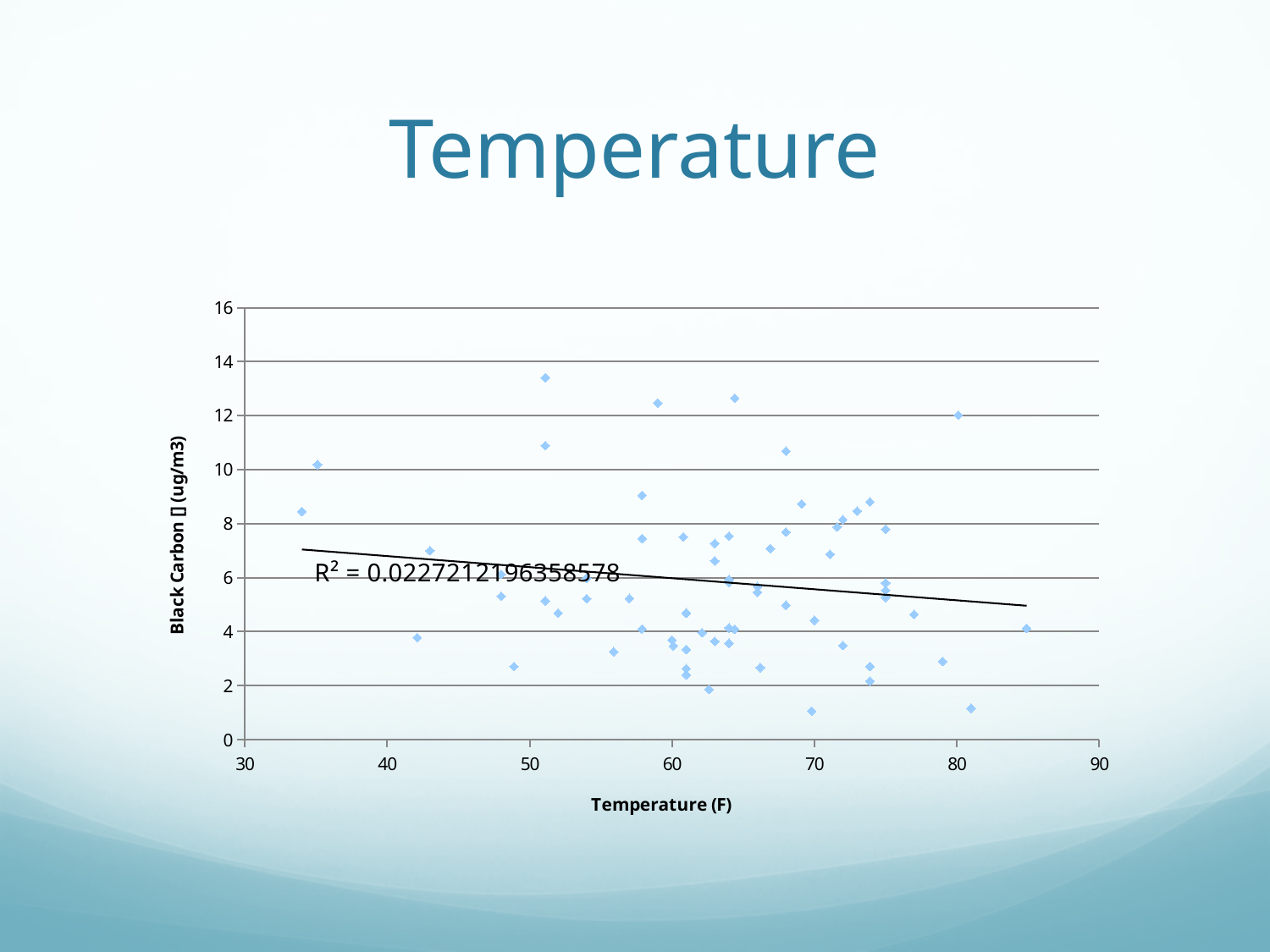
What kind of chart is shown on the slide? scatter chart Is the black carbon value of the rightmost data point (near 85 F) greater or less than 6? less What R-squared value is printed on the chart? 0.0227212196358578 Is the trendline higher at its left end or its right end? left end Is the black carbon value of the highest data point greater or less than 12? greater Is the black carbon value of the lowest data point greater or less than 2? less What is the title of the x axis? Temperature (F) Does the fitted trendline rise or fall as temperature increases along the x axis? fall